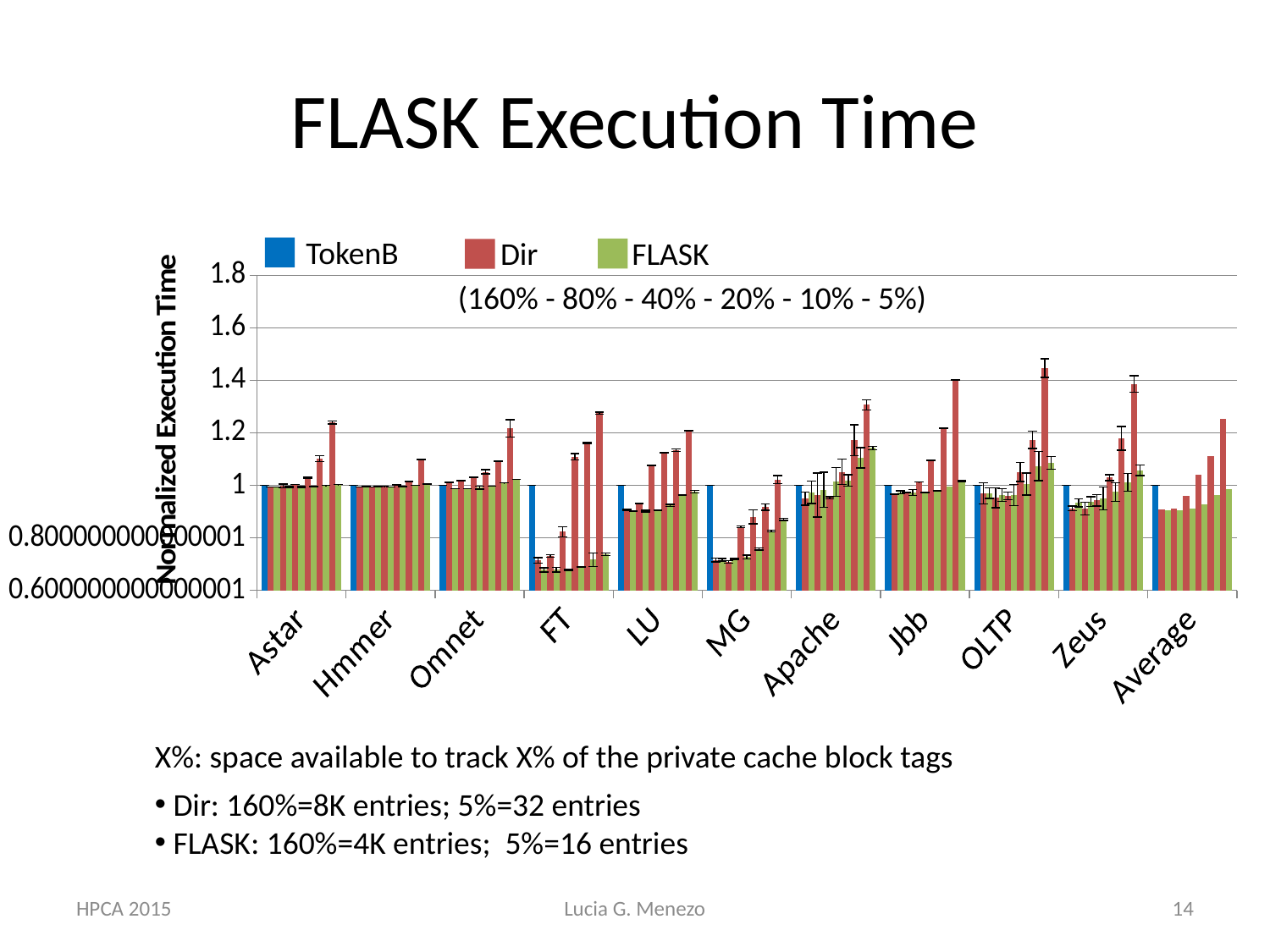
Is the TokenB value for FT greater or less than 0.8? greater How many series does the chart legend list? 3 What kind of chart is shown on the slide? bar chart What are the three series named in the chart legend? TokenB, Dir, FLASK Is the tallest Dir bar for Jbb greater or less than 1.2? greater For FT, which is larger: the TokenB value or the tallest Dir value? Dir Is the tallest Dir bar for OLTP greater or less than 1.2? greater How many categories are shown along the x axis of the chart? 11 What is the title of the y axis of the chart? Normalized Execution Time